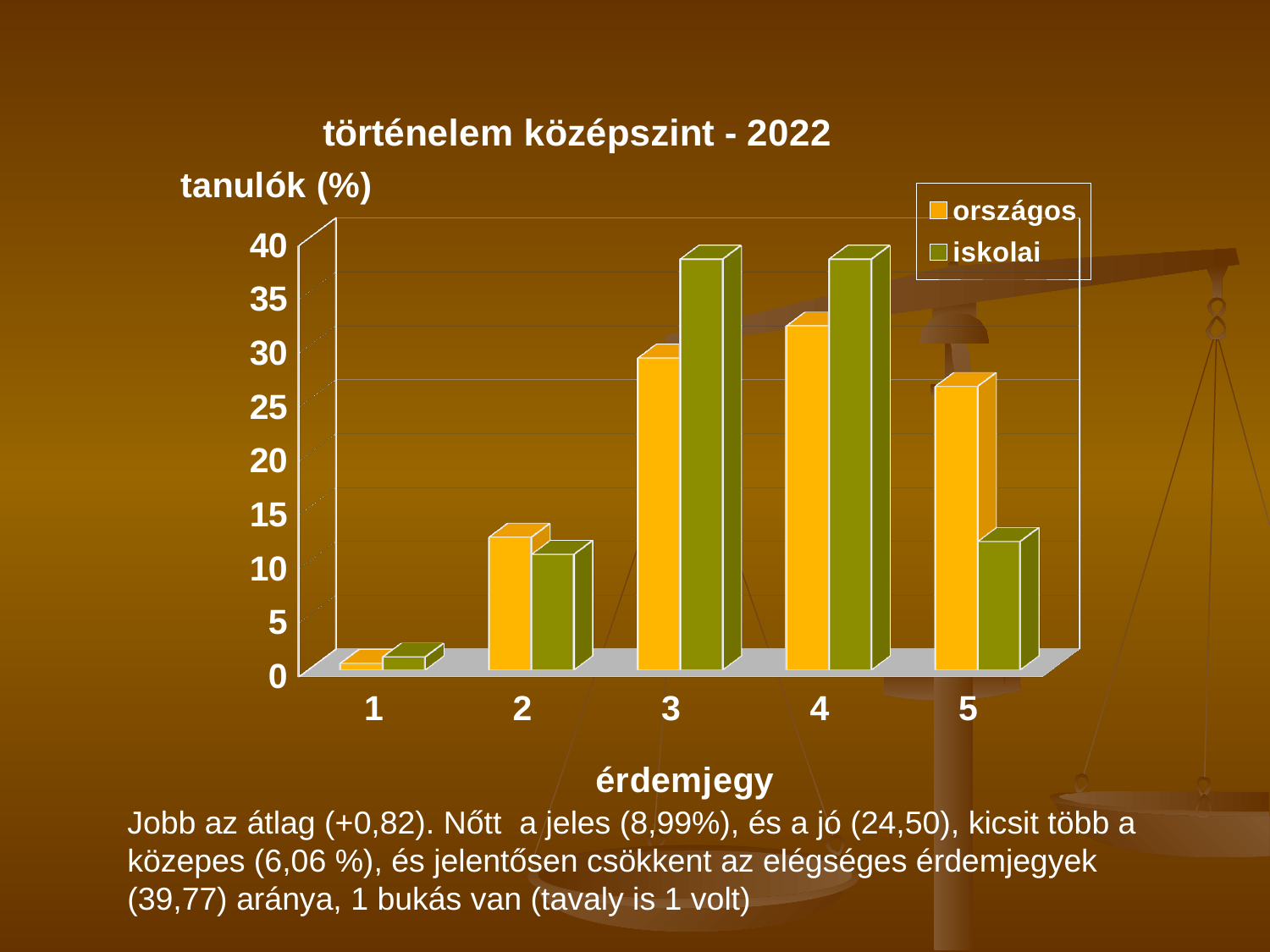
What is the title of the chart? történelem középszint - 2022 Which two series are listed in the legend? országos, iskolai What kind of chart is shown on the slide? bar chart For érdemjegy 5, which series has the larger value, országos or iskolai? országos For which érdemjegy is the országos value the lowest? 1 How many categories (érdemjegy values) are shown on the x axis? 5 For which érdemjegy is the országos value the highest? 4 For érdemjegy 3, which series has the larger value, országos or iskolai? iskolai Is the iskolai value for érdemjegy 5 greater or less than 15? less Is the országos value for érdemjegy 5 greater or less than 30? less Is the iskolai value for érdemjegy 3 greater or less than 35? greater How many series does the legend list? 2